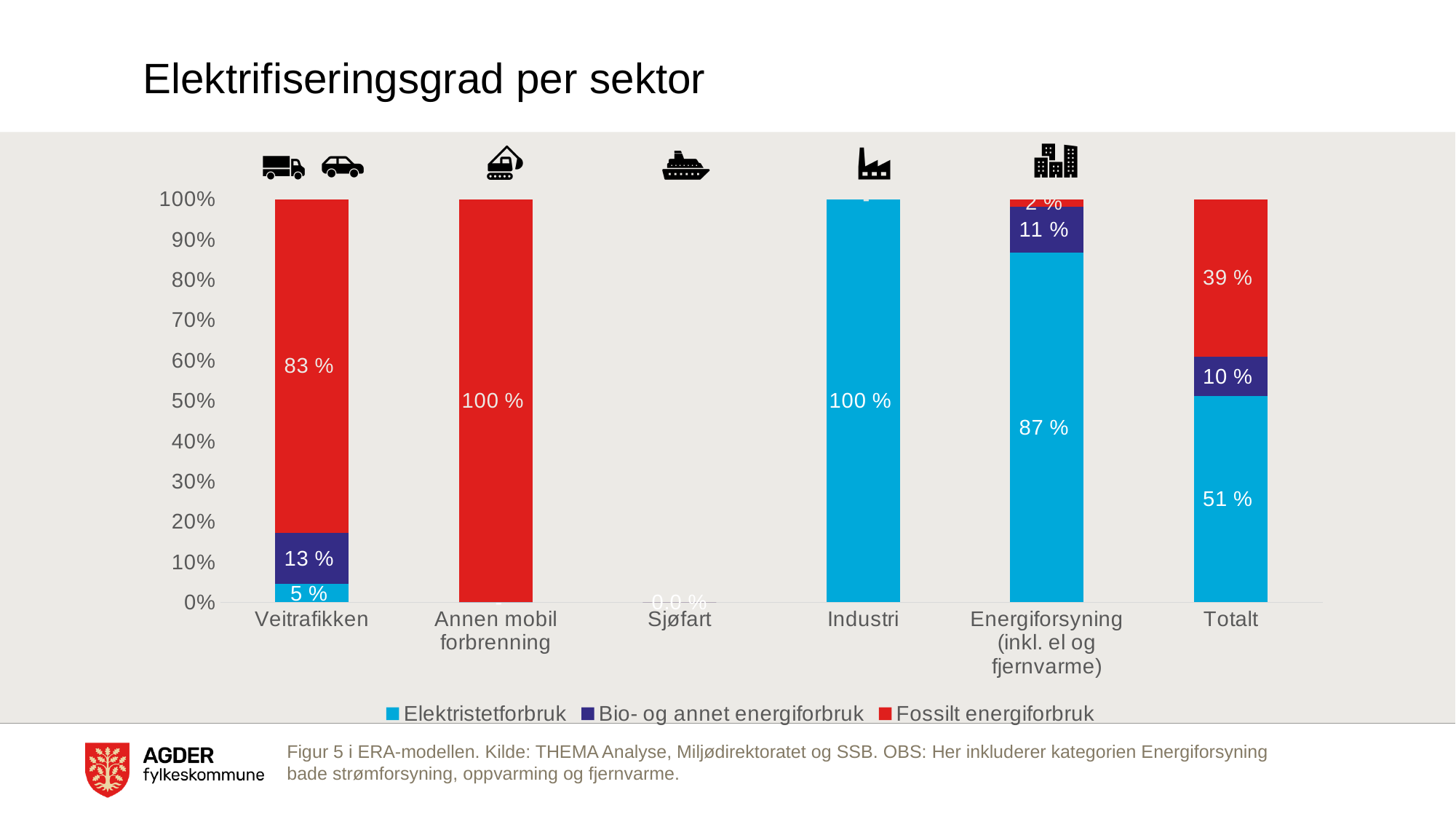
What is the Fossilt energiforbruk share for Veitrafikken? 83 % How many series does the legend list? 3 What kind of chart is shown on the slide? Stacked bar chart Which is larger for Veitrafikken: the Bio- og annet energiforbruk share or the Elektristetforbruk share? Bio- og annet energiforbruk What is the Elektristetforbruk share for Energiforsyning (inkl. el og fjernvarme)? 87 % What is the Bio- og annet energiforbruk share for Totalt? 10 % Which sector has the highest Elektristetforbruk share? Industri How many sector categories are shown on the x axis? 6 What is the difference between the Fossilt energiforbruk share and the Elektristetforbruk share for Totalt? 12 % What is the Fossilt energiforbruk share for Annen mobil forbrenning? 100 % What is the Elektristetforbruk share for Veitrafikken? 5 % Which sector has the highest Fossilt energiforbruk share? Annen mobil forbrenning